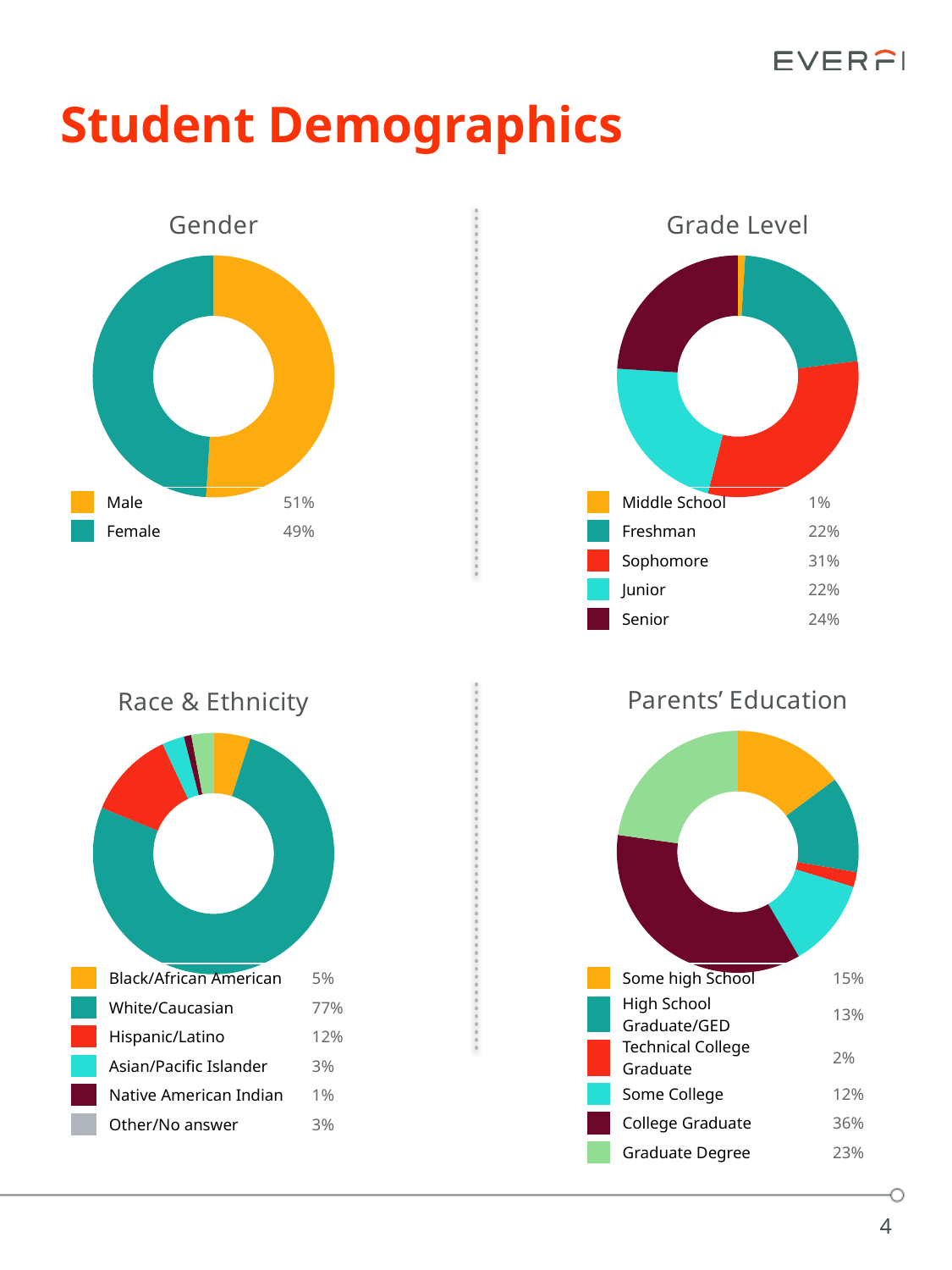
In the Grade Level chart, which grade level has the largest share? Sophomore In the Grade Level chart, which grade level has the smallest share? Middle School In the Parents' Education chart, what is the difference in percentage points between College Graduate and Graduate Degree? 13 In the Parents' Education chart, which is larger: Some high School or Some College? Some high School In the Race & Ethnicity chart, how many categories are listed in the legend? 6 In the Parents' Education chart, what percentage of parents are College Graduates? 36% In the Gender chart, what percentage of students are Male? 51% How many charts are shown on the slide? 4 In the Race & Ethnicity chart, what percentage of students are Hispanic/Latino? 12% In the Grade Level chart, what is the difference in percentage points between Senior and Freshman? 2 What type of chart is used for the Gender chart? Doughnut chart In the Race & Ethnicity chart, which category has the largest share? White/Caucasian